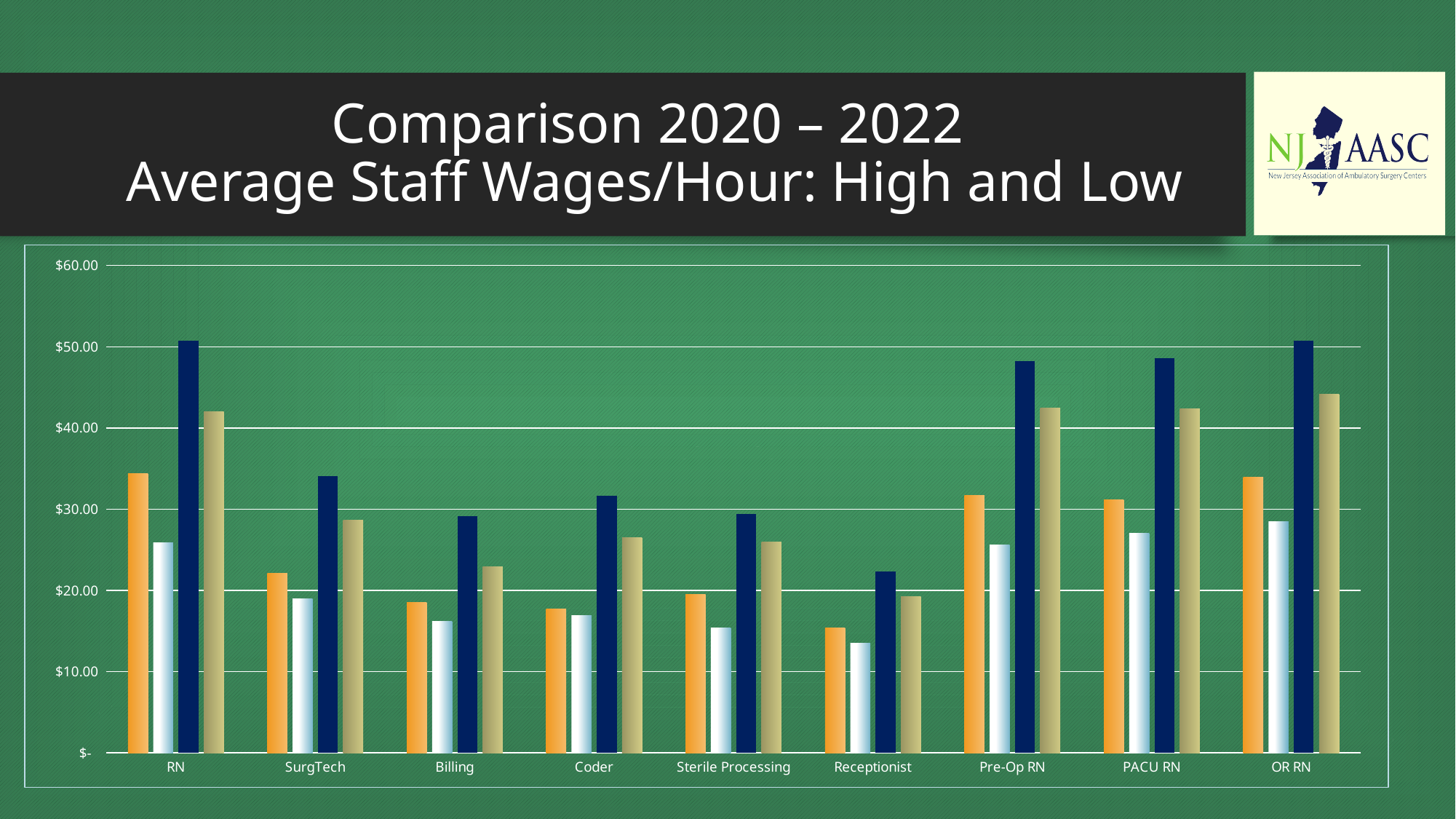
What is the title of the chart on the slide? Comparison 2020 – 2022 Average Staff Wages/Hour: High and Low Which staff category has the shortest navy (dark blue) bar? Receptionist Is the orange bar for RN greater or less than $30.00? greater How many bars are plotted for each staff category? 4 Which is taller, the tan bar for Pre-Op RN or the tan bar for Coder? Pre-Op RN Which is taller, the navy (dark blue) bar for SurgTech or the navy bar for Billing? SurgTech Which staff category has the shortest orange bar? Receptionist Is the tan bar for OR RN greater or less than $40.00? greater How many staff categories are shown on the x axis of the chart? 9 What kind of chart is shown on the slide? bar chart Which staff category has the shortest light blue bar? Receptionist Is the navy (dark blue) bar for Receptionist greater or less than $30.00? less